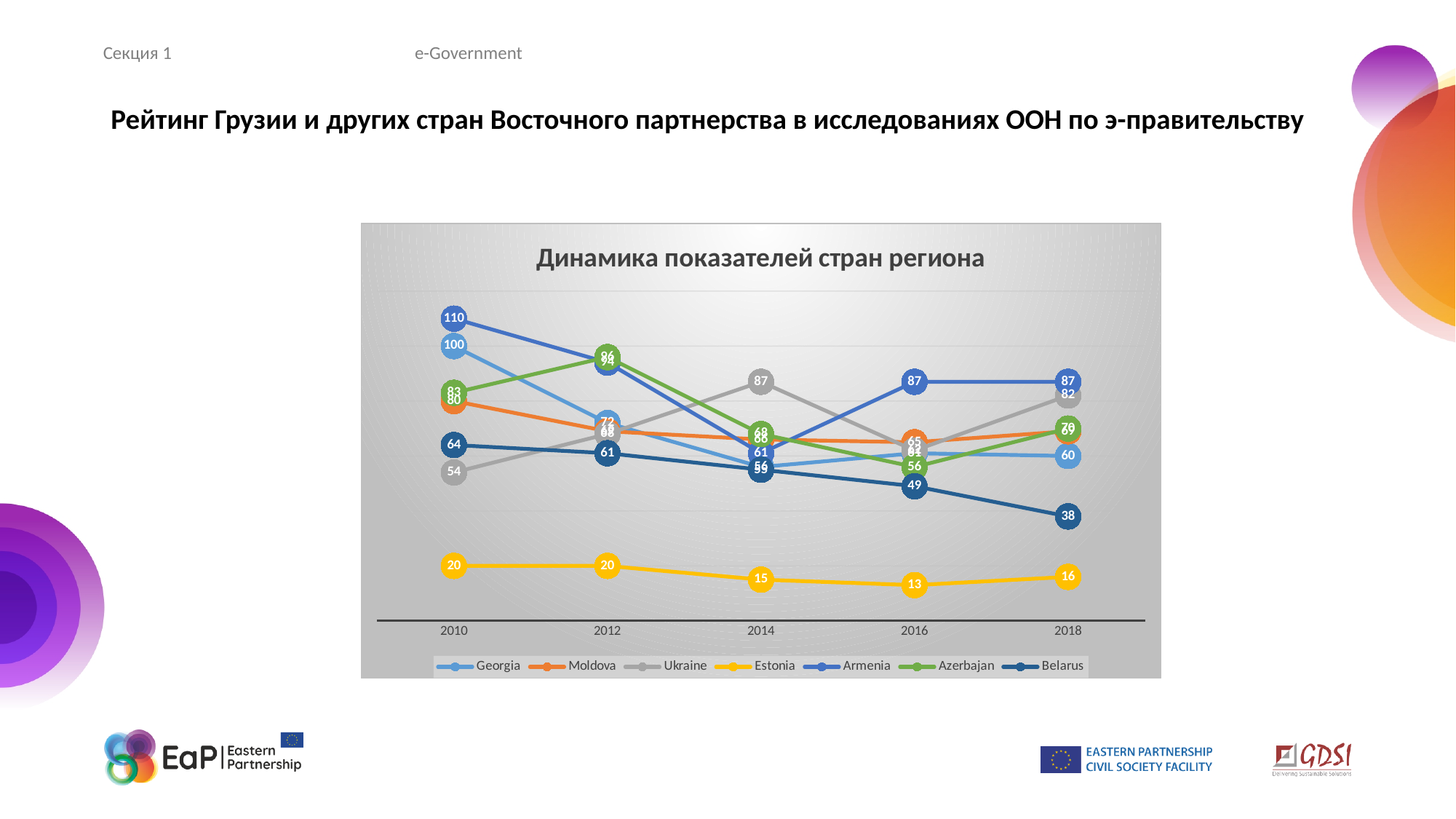
What is the title of the chart? Динамика показателей стран региона What is the value for Armenia in 2010? 110 Which country has the highest value in 2010? Armenia Which country has the lowest value in 2010? Estonia What is the value for Belarus in 2018? 38 What is the value for Estonia in 2016? 13 What is the difference between the Belarus value in 2010 and in 2018? 26 How many years are shown on the x axis of the chart? 5 How many series does the legend of the chart list? 7 What kind of chart is shown on the slide? line chart Does the Belarus line rise or fall from 2010 to 2018? fall What is the value for Georgia in 2010? 100